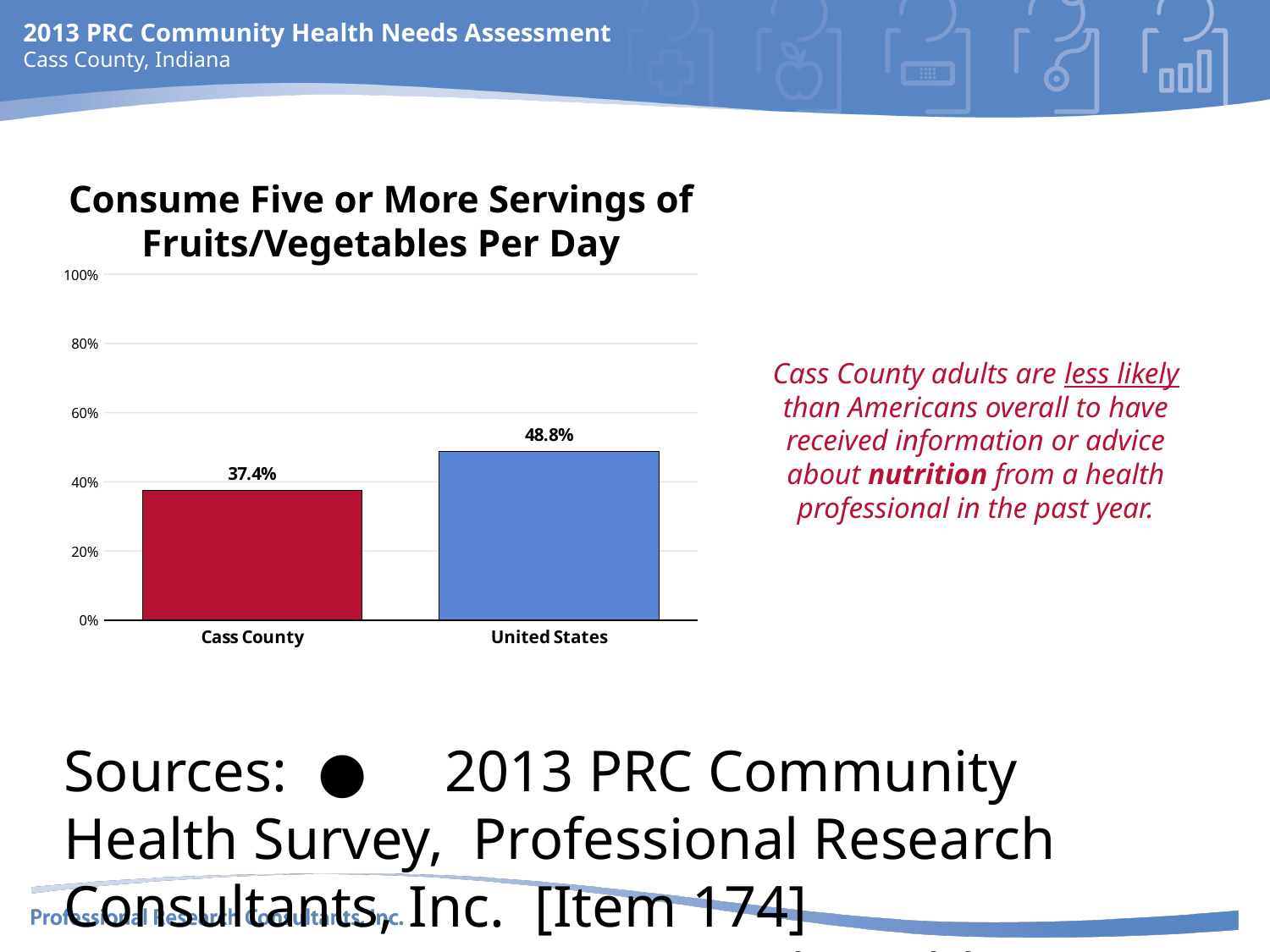
What is the value for United States? 48.8% Which category has the lowest value? Cass County What is the value for Cass County? 37.4% What colour is the bar for Cass County? red Which category has the highest value? United States What is the difference between the United States value and the Cass County value? 11.4% What kind of chart is shown on the slide? bar chart What is the title of the chart? Consume Five or More Servings of Fruits/Vegetables Per Day How many categories are shown on the chart? 2 Which is larger, the value for Cass County or the value for United States? United States Is the value for United States greater or less than 40%? greater Is the value for Cass County greater or less than 40%? less